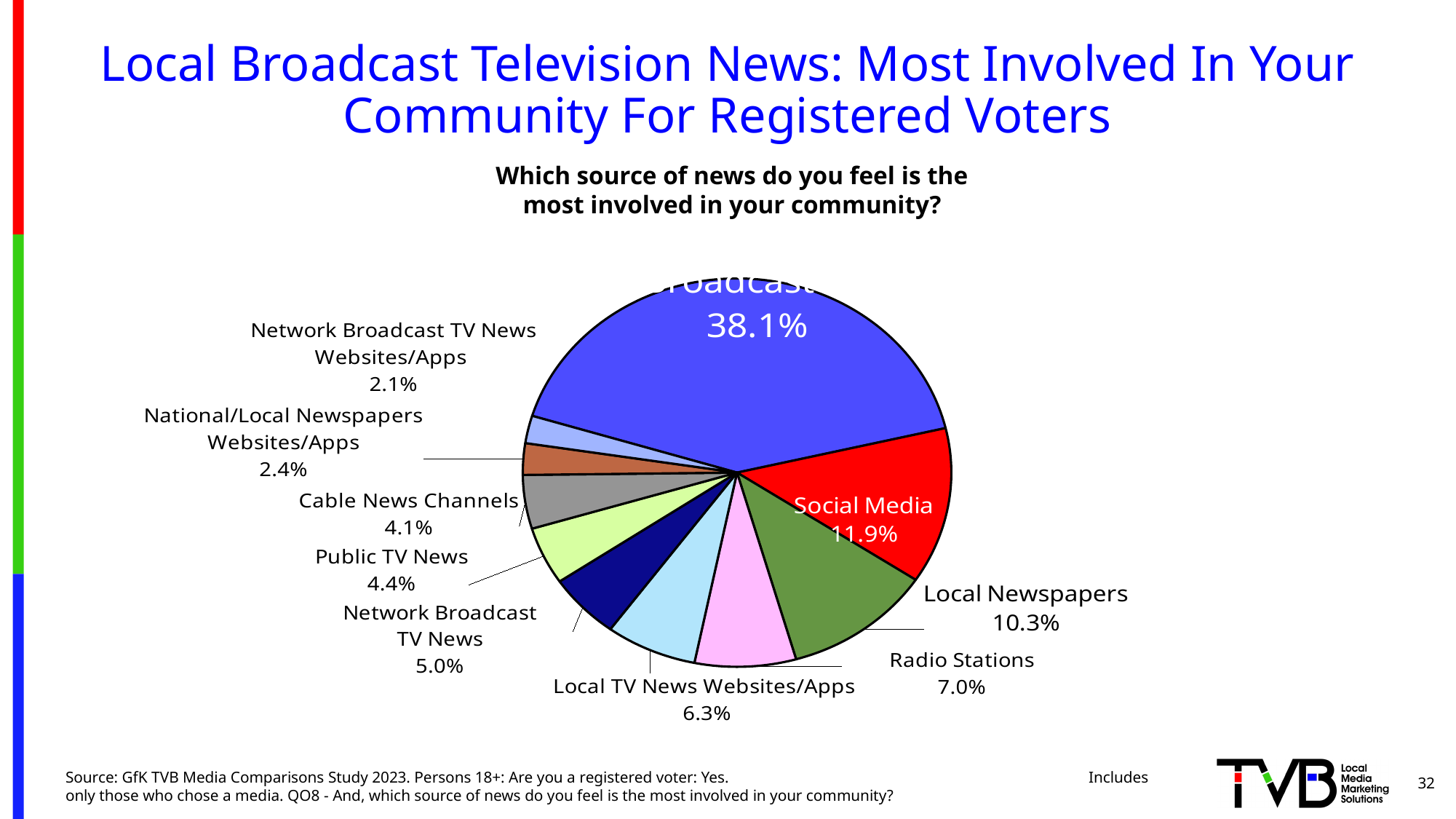
What is the value for Local TV News Websites/Apps? 6.3% What share of the pie does Social Media account for? 11.9% Which category has the smallest slice in the pie chart? Network Broadcast TV News Websites/Apps What is the value of the largest slice in the pie chart? 38.1% What percentage is shown for Cable News Channels? 4.1% What kind of chart is shown on the slide? Pie chart What percentage is shown for Radio Stations? 7.0% What is the difference between Social Media and Local Newspapers? 1.6% How many slices does the pie chart have? 10 What is the value shown for Local Newspapers? 10.3% What question is the chart based on, as shown above the pie? Which source of news do you feel is the most involved in your community? Which is larger, Public TV News or Cable News Channels? Public TV News